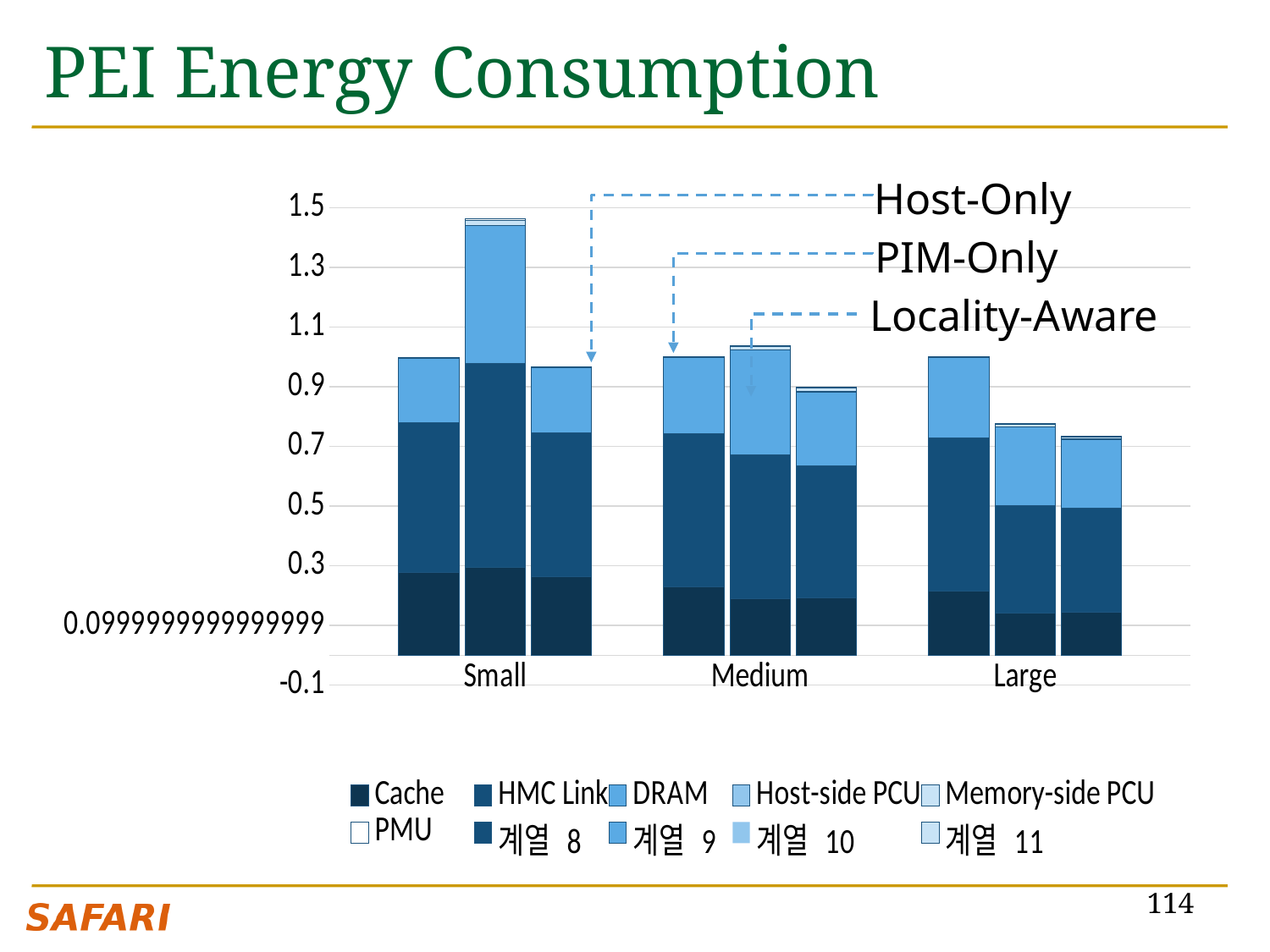
How many categories are shown on the x axis? 3 Which is taller for Large, the Host-Only bar or the Locality-Aware bar? Host-Only What is the title of the chart? PEI Energy Consumption Is the PIM-Only bar for Large greater or less than 0.9? less Which is taller for Small, the PIM-Only bar or the Locality-Aware bar? PIM-Only What are the three bar configurations labelled in the chart? Host-Only, PIM-Only, Locality-Aware Do the PIM-Only bars rise or fall from Small to Large? fall Is the Locality-Aware bar for Large greater or less than 0.9? less Is the PIM-Only bar for Small greater or less than 1.3? greater Which bar is the tallest in the chart? PIM-Only for Small What kind of chart is shown on the slide? stacked bar chart How many series does the legend list? 10